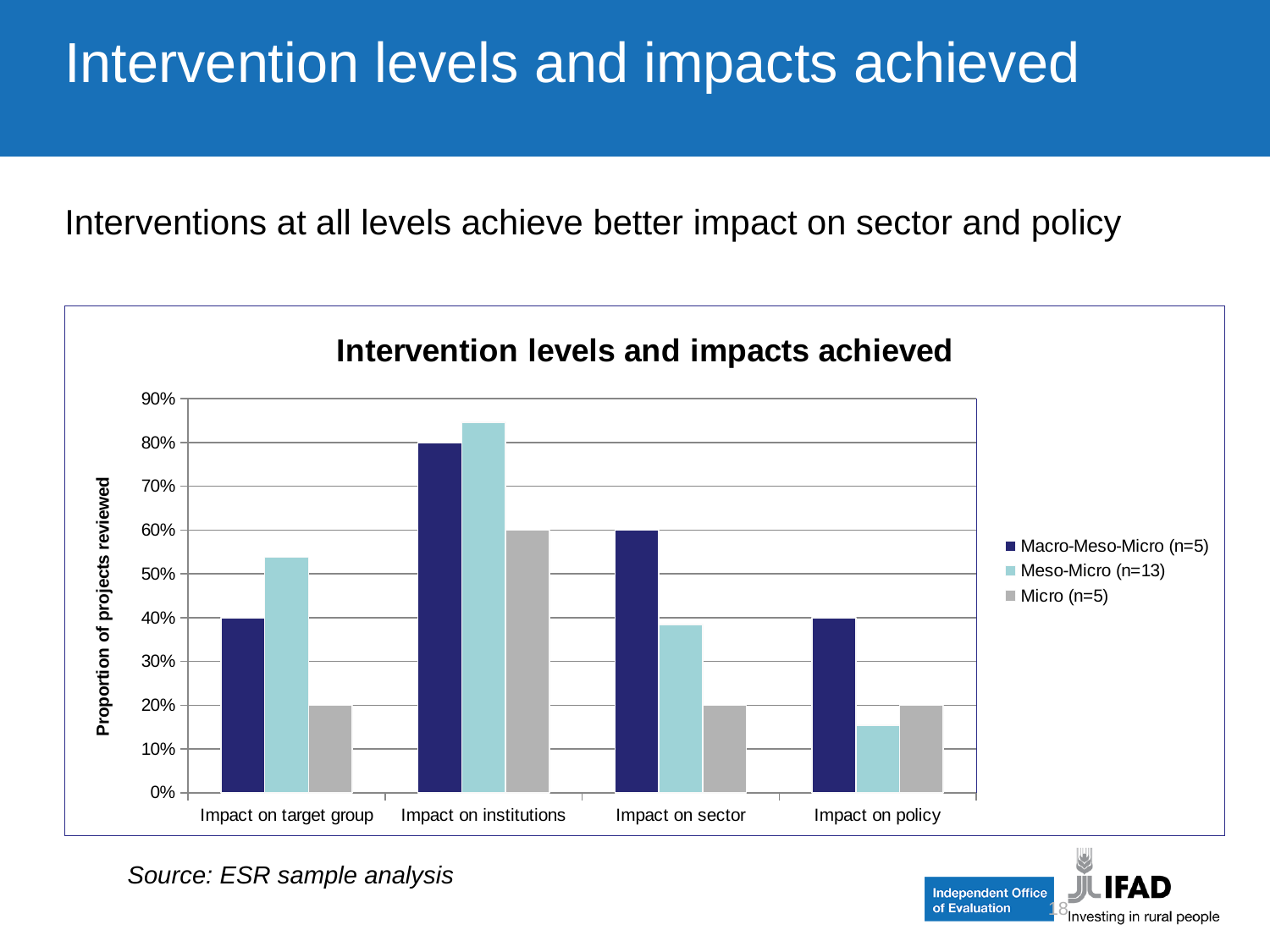
What is the value for Macro-Meso-Micro (n=5) for Impact on sector? 60% For which impact category is the Macro-Meso-Micro (n=5) bar highest? Impact on institutions How many impact categories are shown on the x axis? 4 How many series does the legend list? 3 Is the value for Meso-Micro (n=13) for Impact on policy greater or less than 20%? less What is the value for Macro-Meso-Micro (n=5) for Impact on institutions? 80% For Impact on sector, which series has the larger value: Macro-Meso-Micro (n=5) or Meso-Micro (n=13)? Macro-Meso-Micro (n=5) What is the value for Micro (n=5) for Impact on institutions? 60% What kind of chart is shown on the slide? bar chart What is the label of the y axis? Proportion of projects reviewed Is the value for Meso-Micro (n=13) for Impact on target group greater or less than 50%? greater Is the value for Meso-Micro (n=13) for Impact on institutions greater or less than 80%? greater